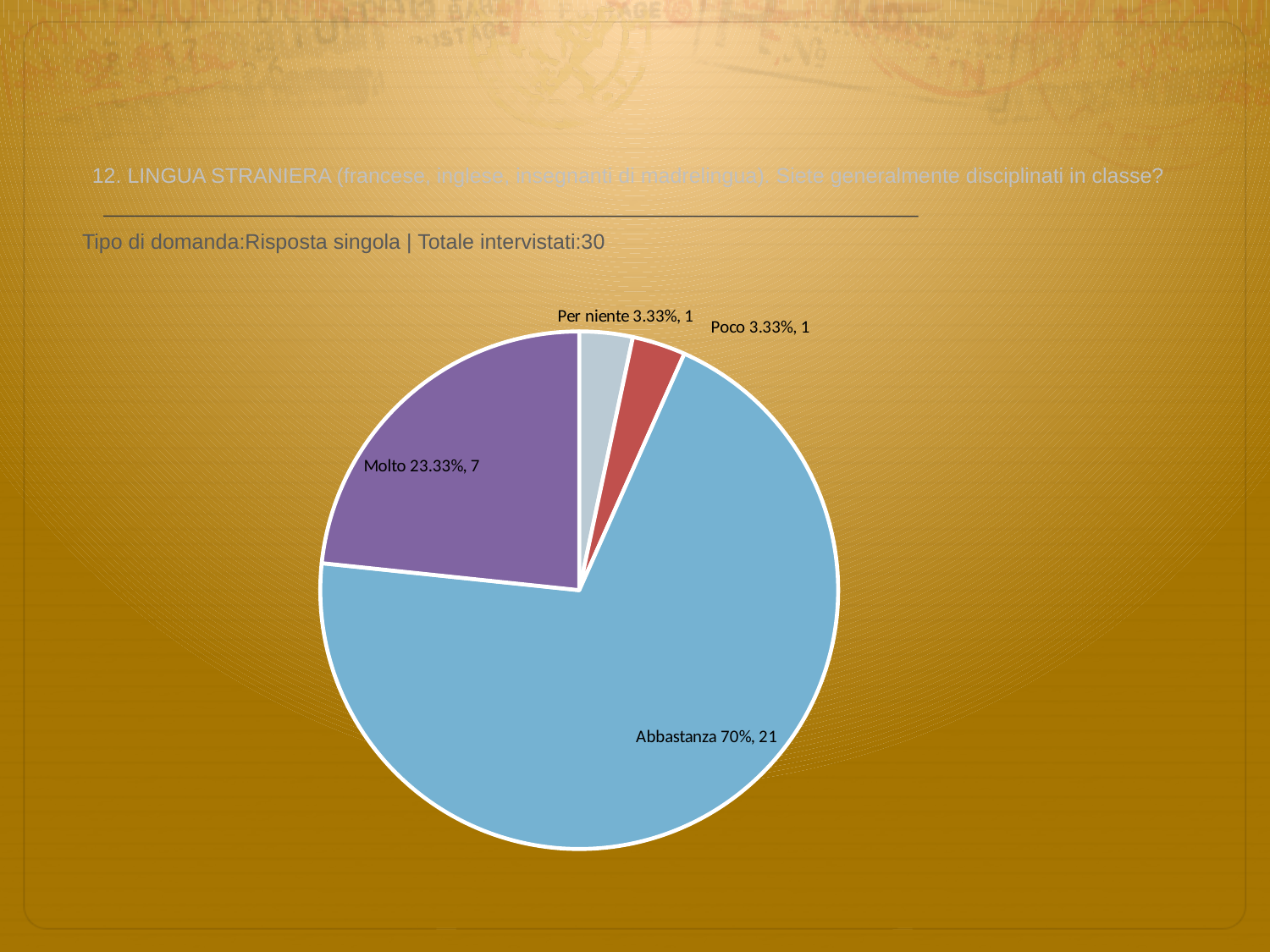
How many respondents answered Poco? 1 Which category has the largest slice? Abbastanza How many slices does the pie chart have? 4 What kind of chart is shown on the slide? pie chart Which is larger, the Molto slice or the Poco slice? Molto What percentage share does the Molto slice have? 23.33% What colour is the Abbastanza slice? light blue What is the difference in respondent count between Abbastanza and Molto? 14 How many respondents answered Molto? 7 What percentage share does the Per niente slice have? 3.33% What is the total number of respondents shown in the subtitle? 30 What percentage share does the Abbastanza slice have? 70%